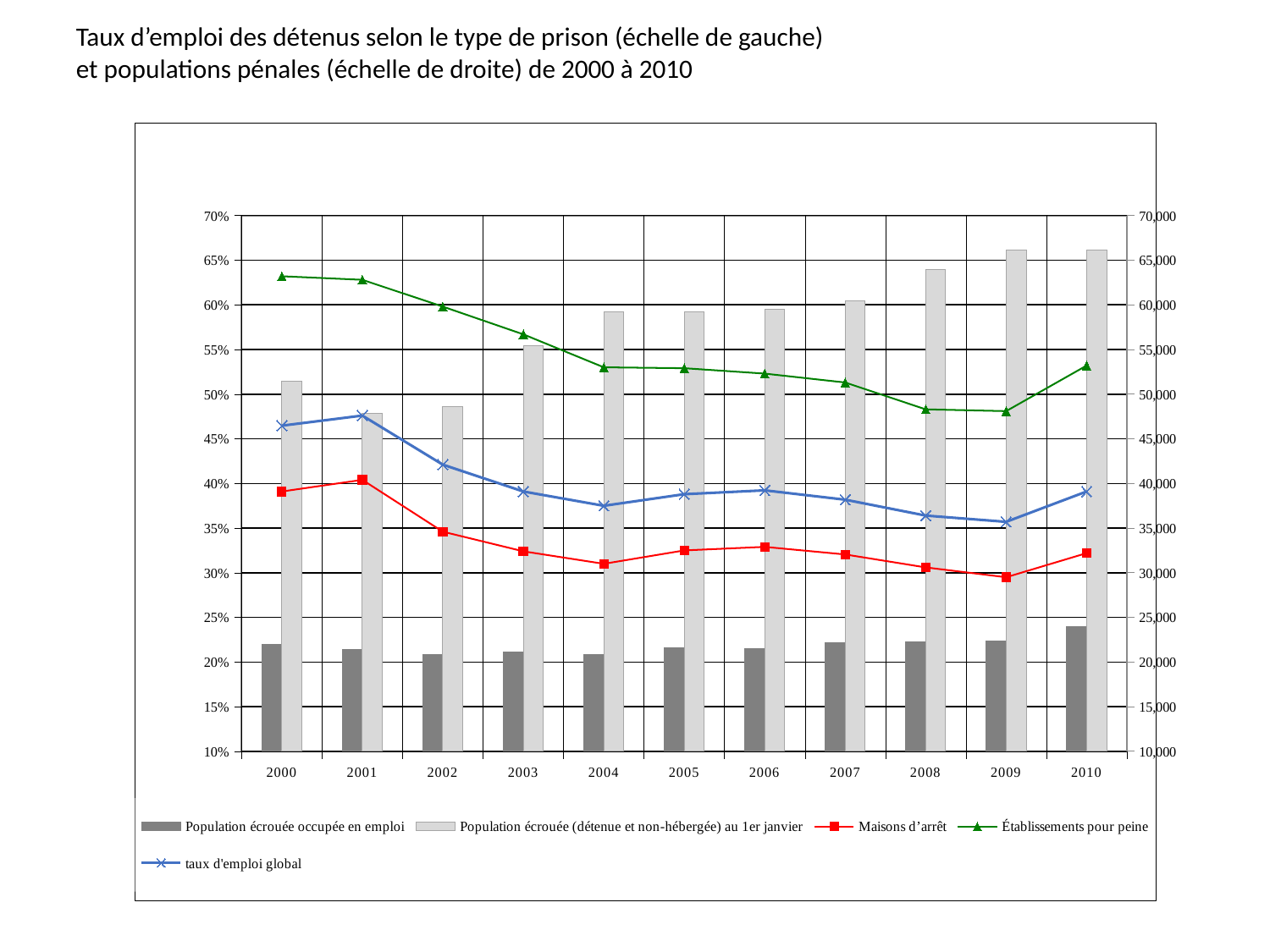
Is the value for 'Maisons d'arrêt' in 2004 greater or less than 35%? less Is the value for 'Établissements pour peine' in 2000 greater or less than 60%? greater Does the 'Établissements pour peine' employment rate rise or fall from 2000 to 2009? Fall In which year is the 'Population écrouée occupée en emploi' bar highest? 2010 Which series is drawn with a green line and triangle markers? Établissements pour peine How many years are shown on the x axis? 11 In which year is the 'Maisons d'arrêt' employment rate highest? 2001 How many series does the legend list? 5 Which is larger in 2000: the employment rate for 'Établissements pour peine' or for 'Maisons d'arrêt'? Établissements pour peine What kind of chart is shown on the slide? A combined bar and line chart Is the 'Population écrouée (détenue et non-hébergée) au 1er janvier' bar for 2010 greater or less than 65,000? greater